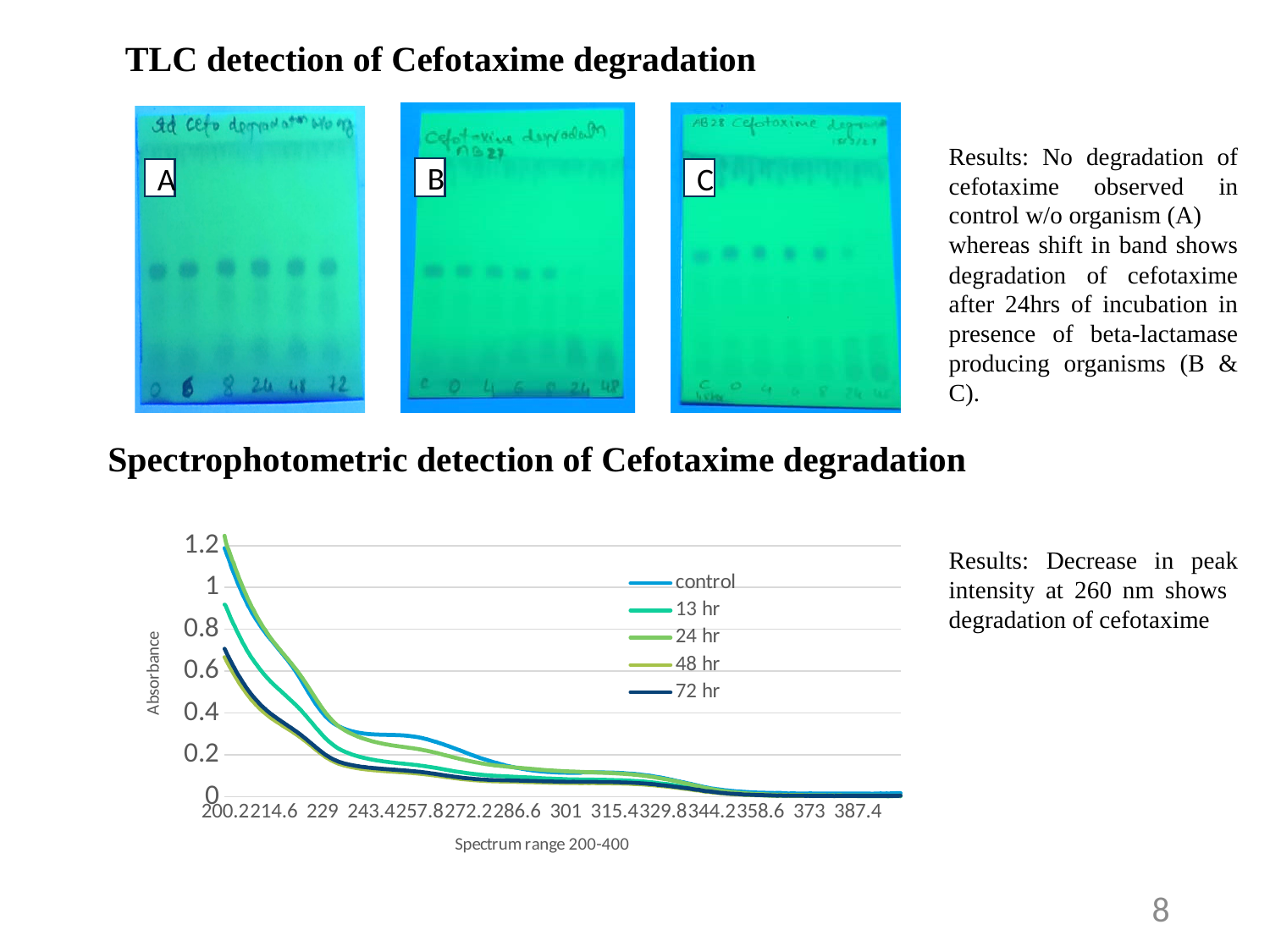
In the absorbance chart, is the value for the 13 hr series at 200.2 greater or less than 0.8? greater How many series does the legend of the absorbance chart list? 5 In the absorbance chart, do the values generally rise or fall as the spectrum range increases along the x axis? fall In the absorbance chart, is the value for the 72 hr series at 243.4 greater or less than 0.2? less In the absorbance chart, which is larger at 200.2: the 13 hr series or the 48 hr series? 13 hr In the absorbance chart, is the value for the control series at 243.4 greater or less than 0.2? greater What is the title of the vertical axis of the absorbance chart? Absorbance In the absorbance chart, which is larger at 200.2: the control series or the 72 hr series? control What kind of chart is shown under 'Spectrophotometric detection of Cefotaxime degradation'? line chart What is the title of the horizontal axis of the absorbance chart? Spectrum range 200-400